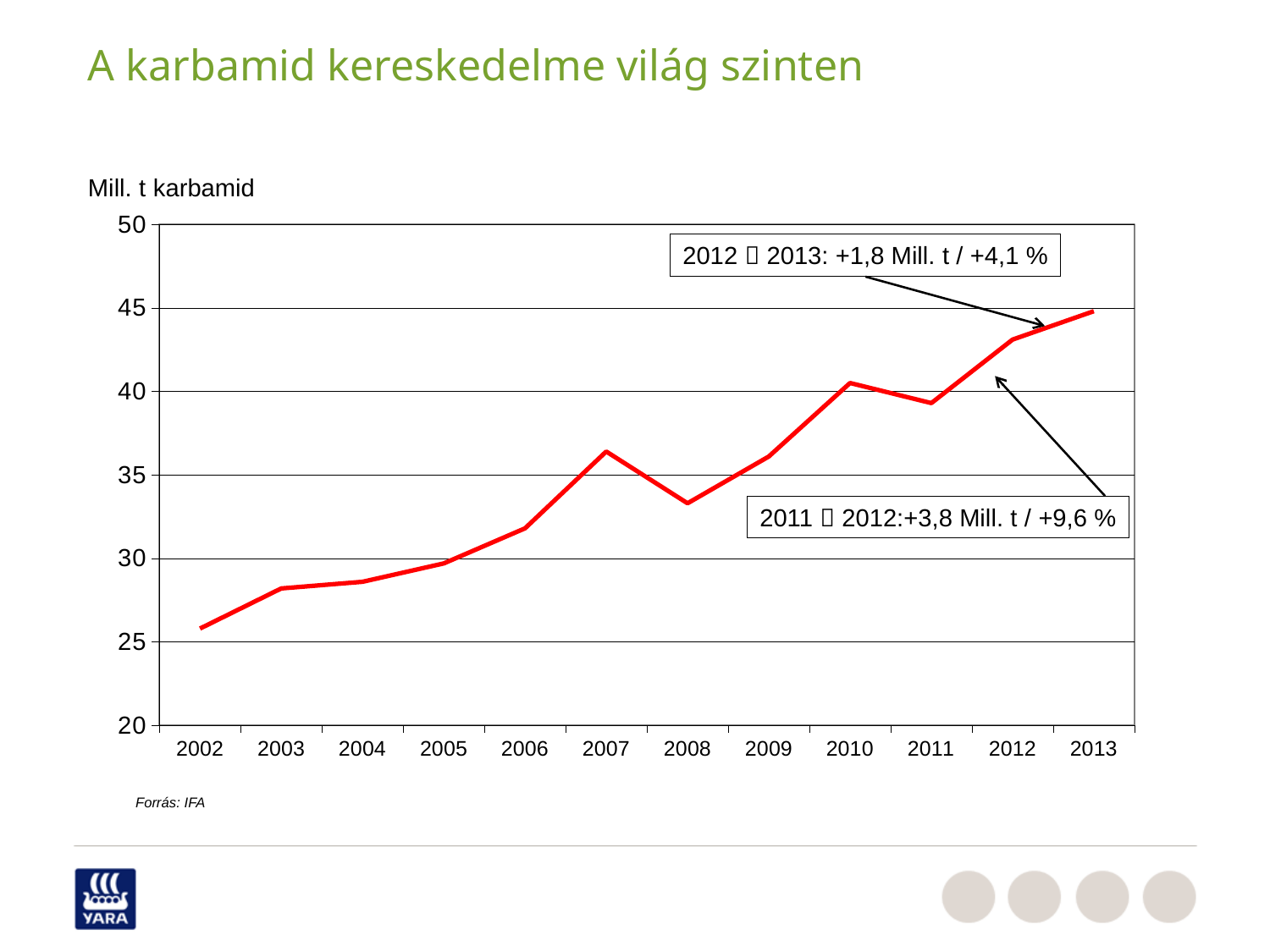
How many years are plotted along the x axis of the chart? 12 Which year has the lowest value on the chart? 2002 According to the annotation, by how much did the value change from 2012 to 2013? +1,8 Mill. t / +4,1 % Which year has the highest value on the chart? 2013 Is the value for 2012 greater or less than 40? greater According to the annotation, what was the percentage change from 2011 to 2012? +9,6 % Is the value for 2002 greater or less than 30? less What kind of chart is shown on the slide? line chart Do the values generally rise or fall from 2002 to 2013? rise Is the value for 2007 greater or less than 35? greater Which year has the larger value, 2007 or 2008? 2007 What unit is shown above the y axis of the chart? Mill. t karbamid